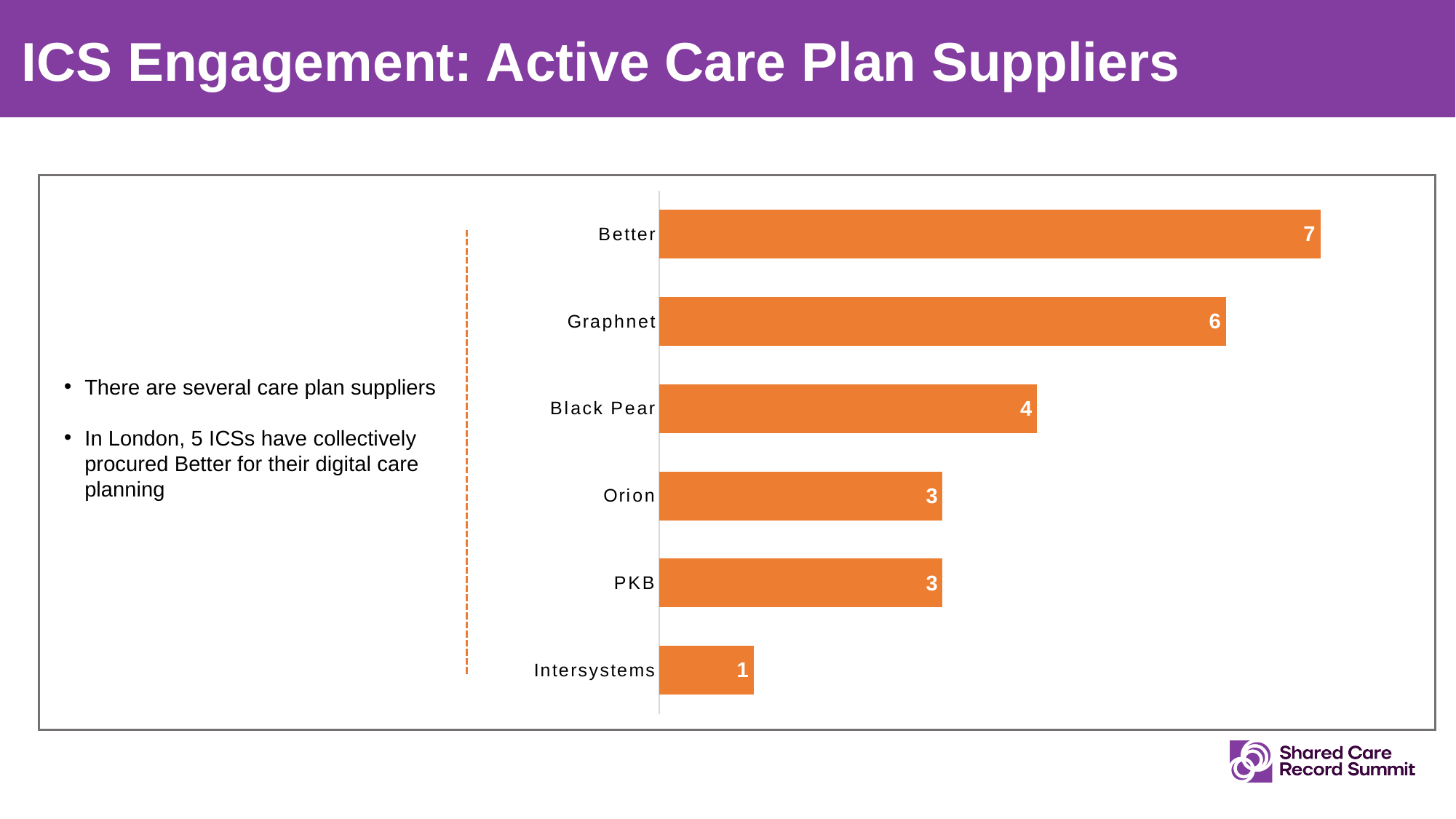
What is the value for Graphnet? 6 What is the value for Better? 7 What is the difference between the values for Better and Graphnet? 1 Which is larger, the value for Graphnet or the value for Black Pear? Graphnet What is the value for Intersystems? 1 What colour are the bars in the chart? Orange What kind of chart is shown on the slide? Bar chart How many suppliers are shown in the chart? 6 Which supplier has the highest value? Better What is the value for Black Pear? 4 What is the difference between the values for Black Pear and Intersystems? 3 Which supplier has the lowest value? Intersystems